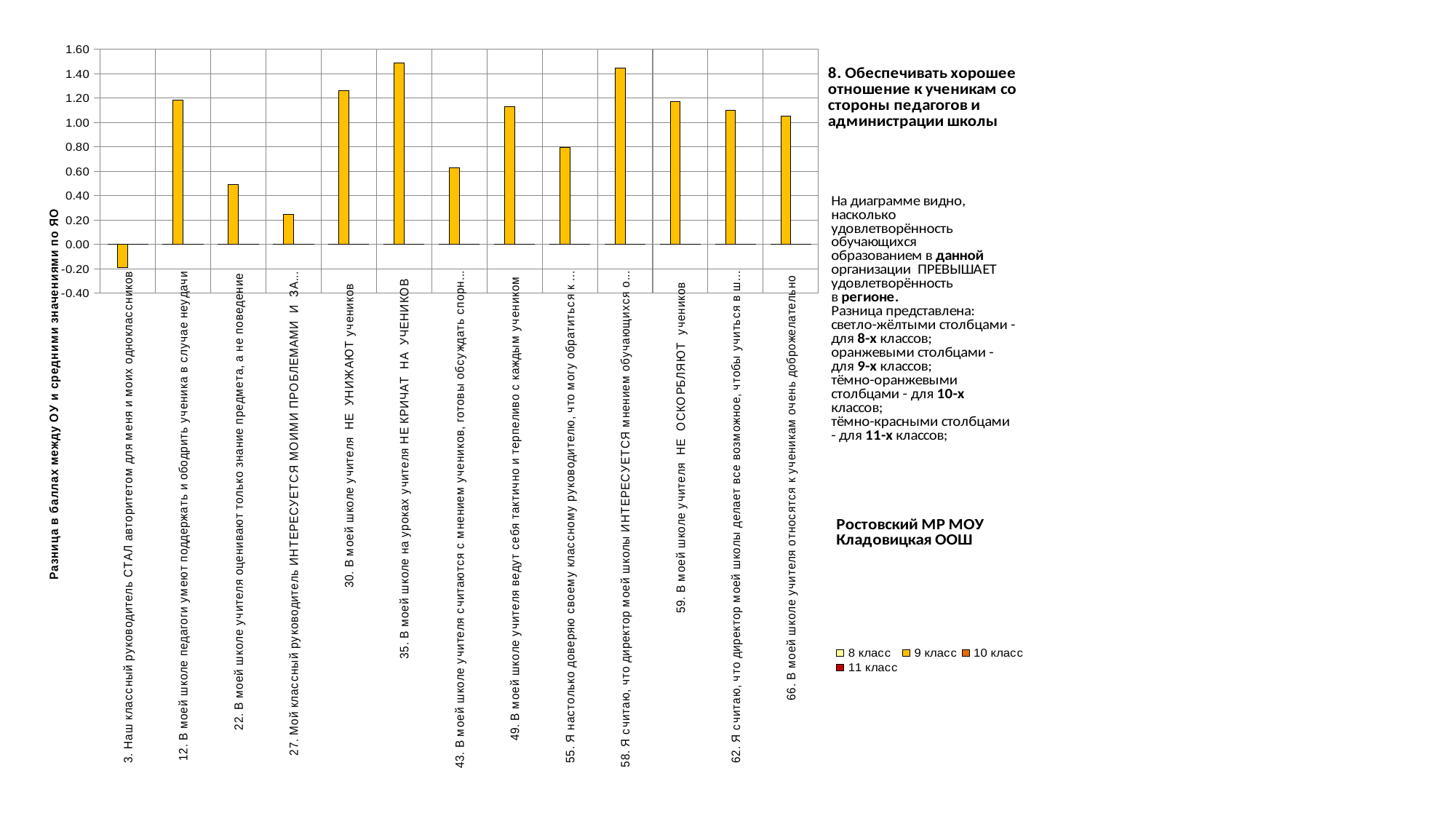
Is the value for category 12 (педагоги умеют поддержать и ободрить ученика) greater or less than 1.00? greater Is the value for category 55 (доверяю своему классному руководителю) greater or less than 1.00? less How many series does the chart's legend list? 4 How many categories (statements) are plotted along the x axis of the chart? 13 Which category has the lowest value in the chart? 3. Наш классный руководитель СТАЛ авторитетом для меня и моих одноклассников Is the value for category 27 (классный руководитель ИНТЕРЕСУЕТСЯ МОИМИ ПРОБЛЕМАМИ) greater or less than 0.40? less What is the title of the chart's vertical axis? Разница в баллах между ОУ и средними значениями по ЯО What kind of chart is shown on the slide? bar chart Which is larger: the value for category 12 (педагоги умеют поддержать и ободрить ученика) or category 22 (учителя оценивают только знание предмета)? category 12 Which is larger: the value for category 35 (учителя НЕ КРИЧАТ НА УЧЕНИКОВ) or category 43 (учителя считаются с мнением учеников)? category 35